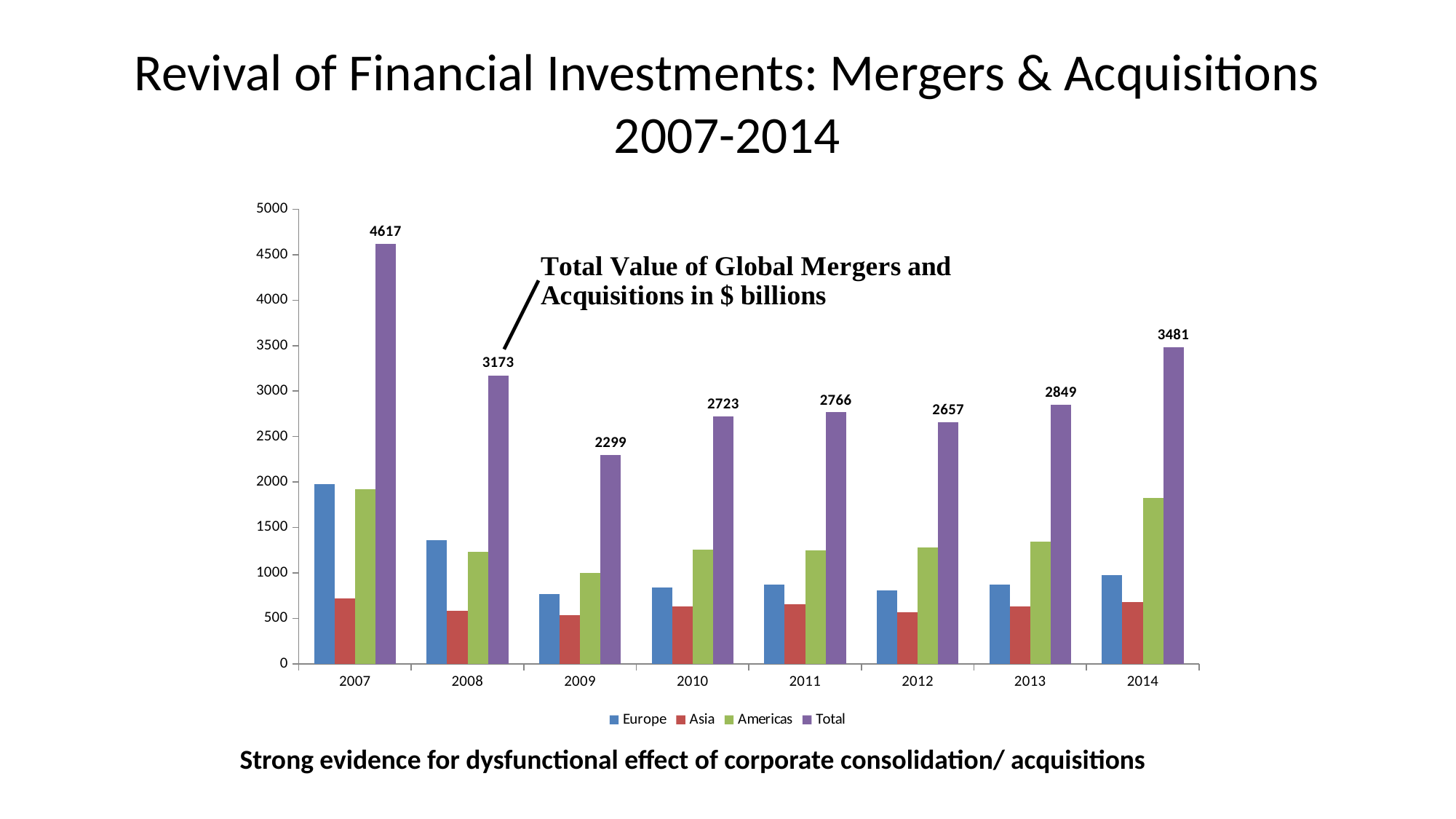
What is the difference between the Total values for 2007 and 2008? 1444 What is the Total value for 2014? 3481 Which year has the lowest Total value? 2009 What is the Total value for 2009? 2299 How many series does the legend list? 4 What kind of chart is shown on the slide? Bar chart Which year has the highest Total value? 2007 Is the value for Asia in 2009 greater or less than 1000? less What is the Total value for 2007? 4617 How many years are shown on the x axis? 8 Which is larger, the Total value for 2011 or for 2012? 2011 Is the value for Europe in 2007 greater or less than 1500? greater